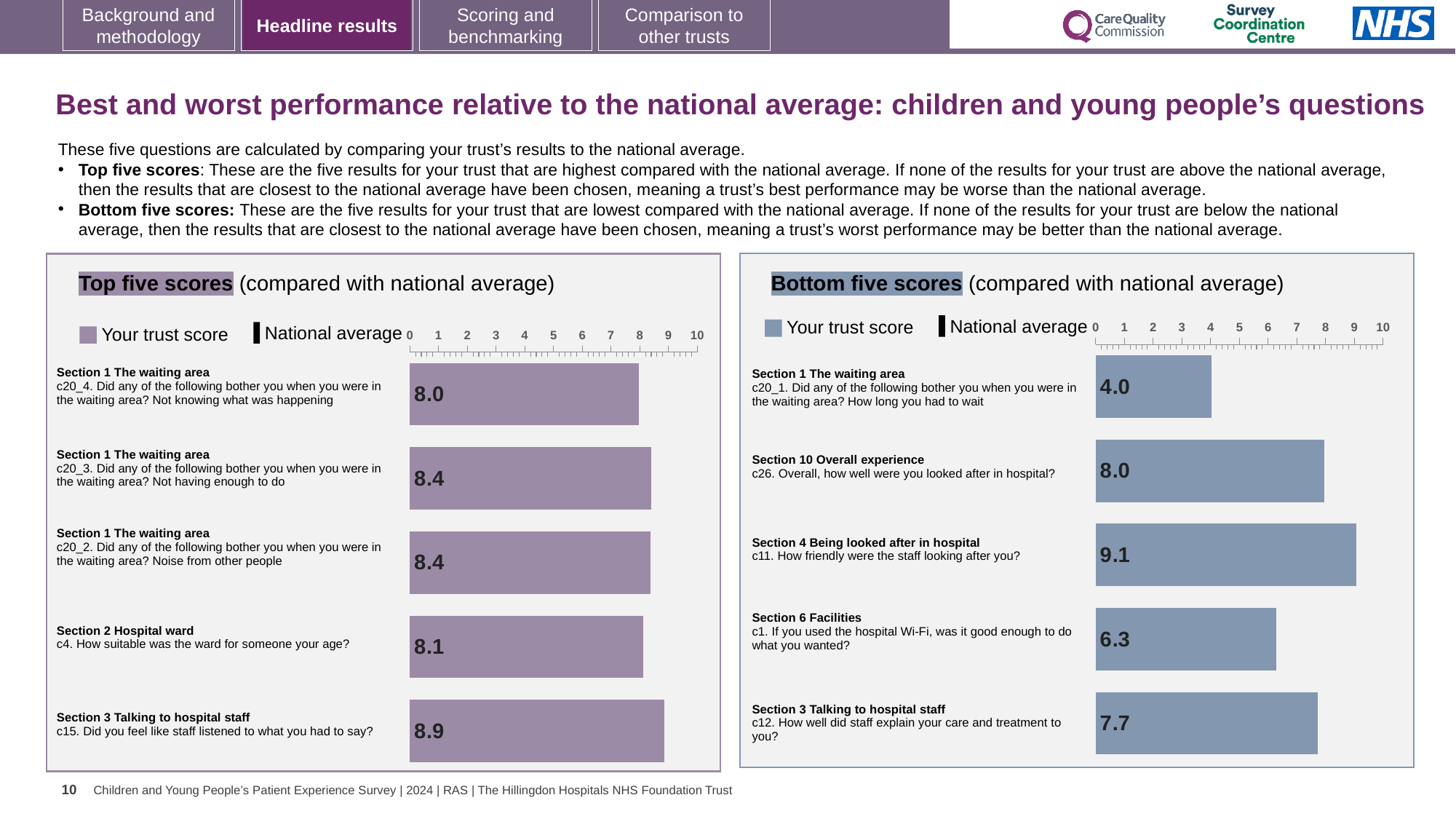
How many questions are shown in the Bottom five scores chart? 5 In the Top five scores chart, what is the trust score for c15 (Did you feel like staff listened to what you had to say)? 8.9 In the Top five scores chart, which question has the lowest trust score? c20_4. Did any of the following bother you when you were in the waiting area? Not knowing what was happening In the Bottom five scores chart, what is the difference between the trust scores for c11 and c20_1? 5.1 In the Bottom five scores chart, what is the trust score for c20_1 (How long you had to wait)? 4.0 In the Top five scores chart, what is the trust score for c20_4 (Not knowing what was happening)? 8.0 In the Bottom five scores chart, which question has the lowest trust score? c20_1. Did any of the following bother you when you were in the waiting area? How long you had to wait Which is larger: the trust score for c26 in the Bottom five scores chart or the trust score for c4 in the Top five scores chart? c4 (8.1) In the Top five scores chart, which question has the highest trust score? c15. Did you feel like staff listened to what you had to say? In the Top five scores chart, what is the difference between the trust scores for c15 and c4? 0.8 In the Bottom five scores chart, what is the trust score for c1 (hospital Wi-Fi)? 6.3 In the Bottom five scores chart, which question has the highest trust score? c11. How friendly were the staff looking after you?